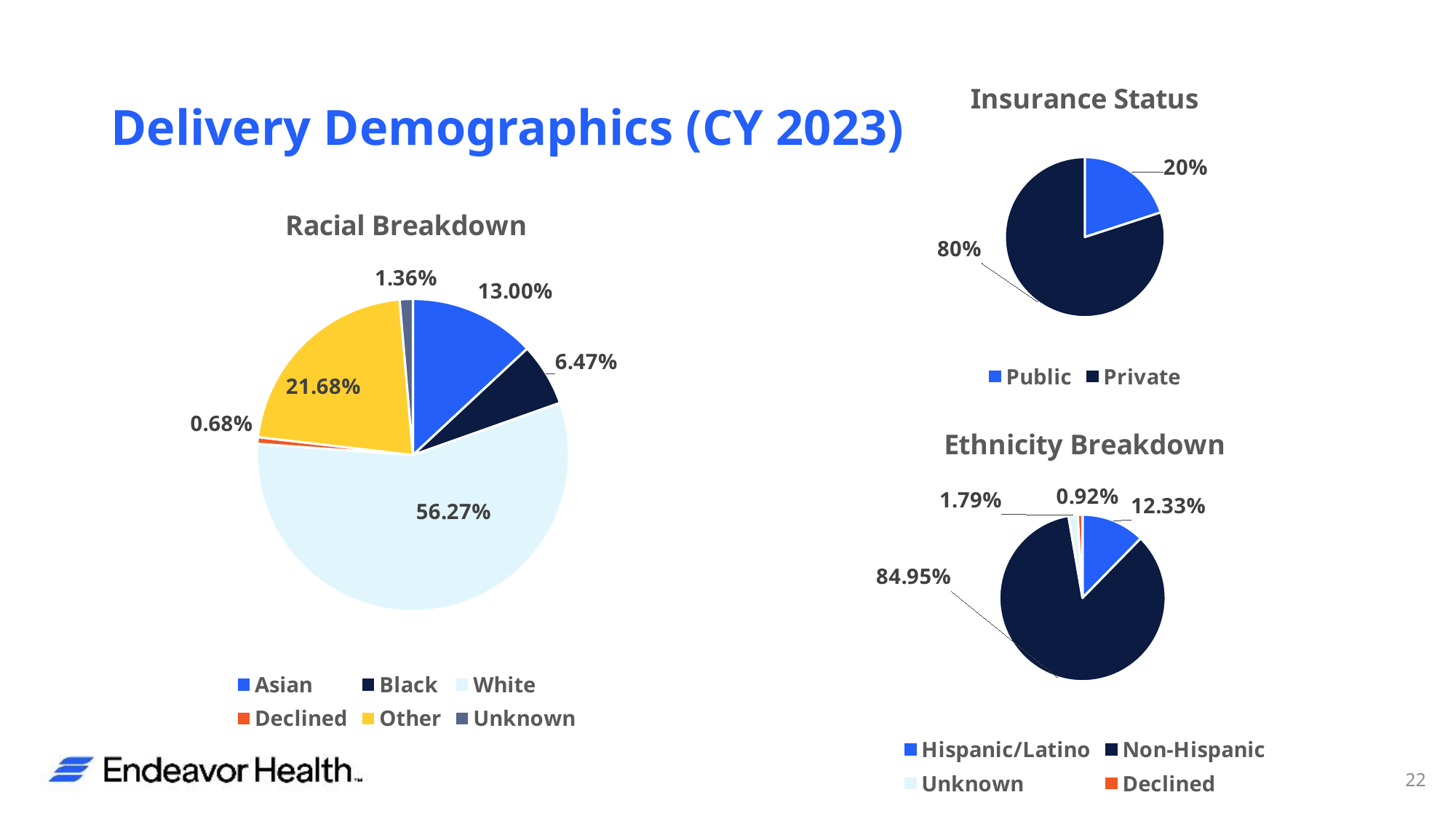
In the Insurance Status chart, what percentage is Private? 80% In the Ethnicity Breakdown chart, what percentage is shown for Non-Hispanic? 84.95% In the Racial Breakdown chart, what percentage is shown for Other? 21.68% In the Insurance Status chart, which is larger, Public or Private? Private In the Ethnicity Breakdown chart, what percentage is shown for Hispanic/Latino? 12.33% How many categories does the Racial Breakdown legend list? 6 In the Racial Breakdown chart, what percentage is shown for Black? 6.47% What type of chart is the Insurance Status chart? Pie chart In the Racial Breakdown chart, which category has the largest share? White In the Racial Breakdown chart, what is the difference between the Asian and Black percentages? 6.53% In the Racial Breakdown chart, which category has the smallest share? Declined In the Racial Breakdown chart, what percentage is shown for White? 56.27%